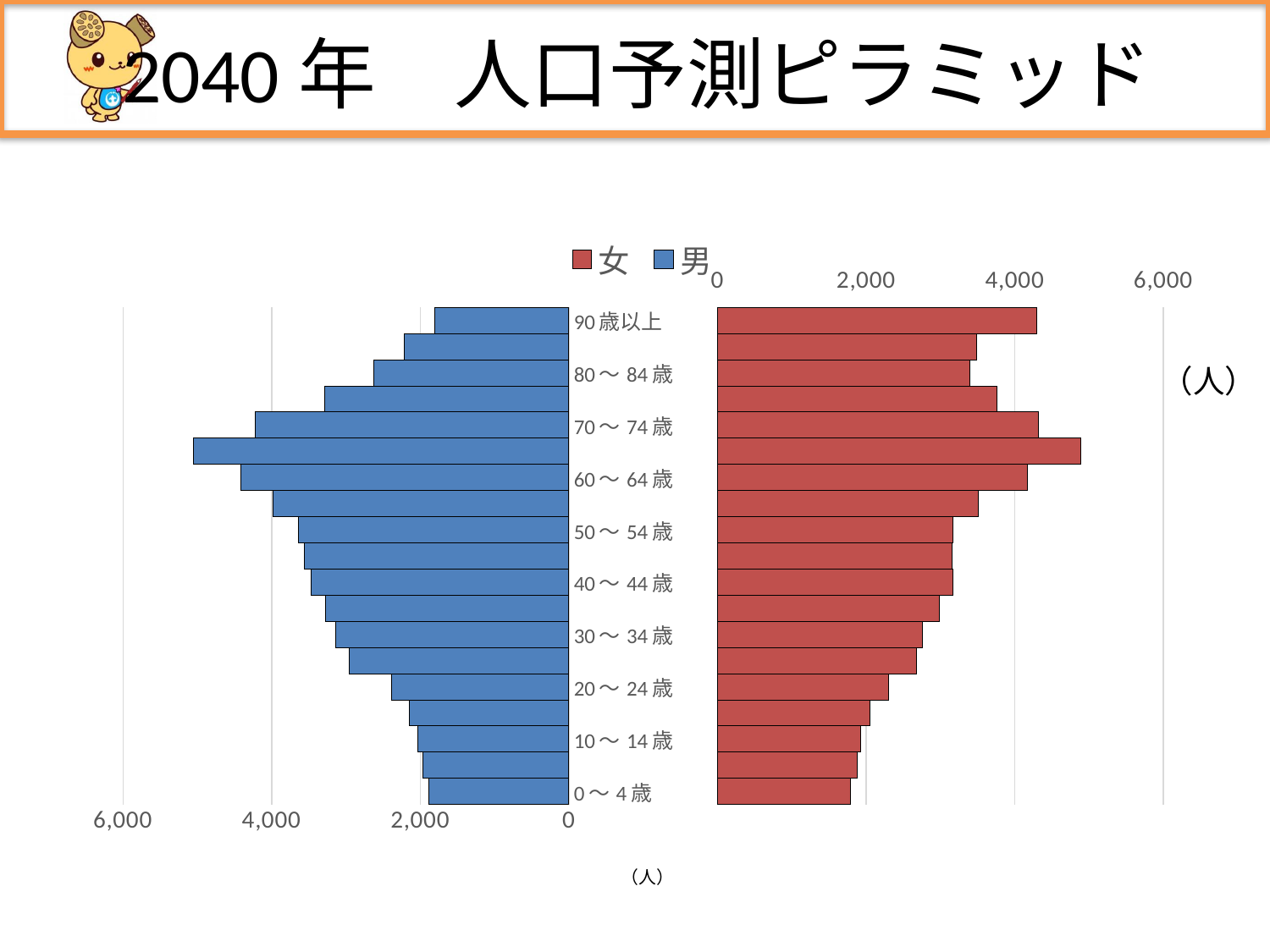
Moving from 0～4歳 up to 60～64歳, do the 男 values rise or fall? rise What is the title of the chart on the slide? 2040年 人口予測ピラミッド Is the 男 value for 0～4歳 greater or less than 2,000? less Which is larger for 男: the value for 70～74歳 or the value for 0～4歳? 70～74歳 How many series does the legend list? 2 Is the 男 value for 70～74歳 greater or less than 4,000? greater Is the 女 value for 0～4歳 greater or less than 2,000? less What kind of chart is shown on the slide? bar chart How many age groups are plotted in the chart? 19 Which colour represents 男 in the chart? blue